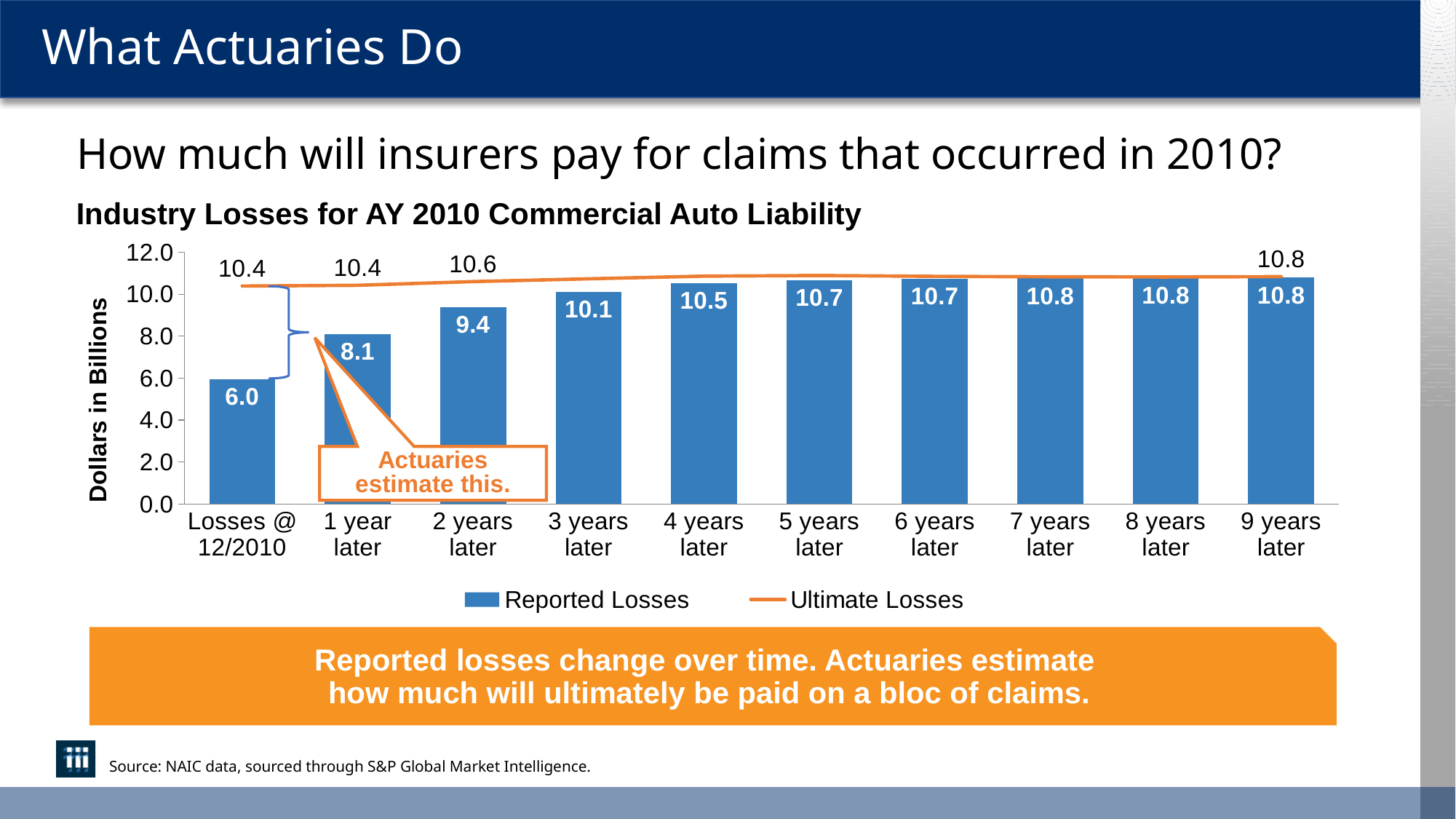
What is the title of the chart? Industry Losses for AY 2010 Commercial Auto Liability What is the Reported Losses value 3 years later? 10.1 How many series does the legend list? 2 What is the Ultimate Losses value 2 years later? 10.6 Is the Reported Losses value 1 year later greater or less than 8.0? greater How many categories are shown on the x axis? 10 Do the Reported Losses values rise or fall from Losses @ 12/2010 to 9 years later? rise What is the Reported Losses value at Losses @ 12/2010? 6.0 What is the difference between the Reported Losses value 1 year later and at Losses @ 12/2010? 2.1 Which is larger: Reported Losses 2 years later or Reported Losses 4 years later? 4 years later Which category has the lowest Reported Losses value? Losses @ 12/2010 What is the Ultimate Losses value at Losses @ 12/2010? 10.4